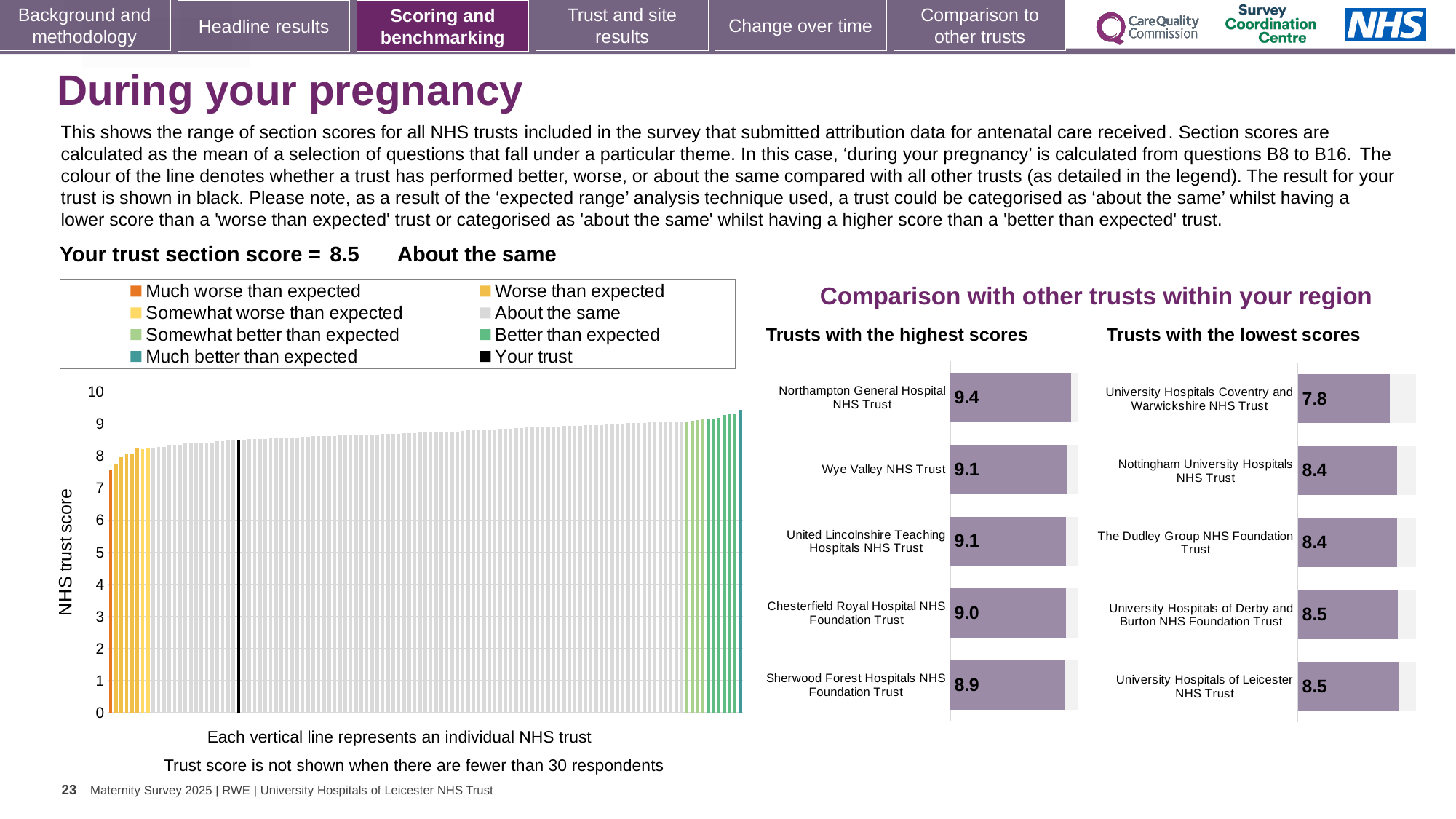
How many entries does the legend of the main chart on the left list? 8 In the 'Trusts with the highest scores' chart, which has the higher score: Wye Valley NHS Trust or Chesterfield Royal Hospital NHS Foundation Trust? Wye Valley NHS Trust In the main chart on the left, do the trust scores rise or fall from left to right? rise In the 'Trusts with the lowest scores' chart, what is the difference between the scores of University Hospitals of Leicester NHS Trust and University Hospitals Coventry and Warwickshire NHS Trust? 0.7 In the 'Trusts with the highest scores' chart, which trust has the lowest score? Sherwood Forest Hospitals NHS Foundation Trust In the 'Trusts with the lowest scores' chart, what is the score for University Hospitals Coventry and Warwickshire NHS Trust? 7.8 In the 'Trusts with the lowest scores' chart, which trust has the lowest score? University Hospitals Coventry and Warwickshire NHS Trust How many trusts are listed in the 'Trusts with the lowest scores' chart? 5 In the 'Trusts with the highest scores' chart, what is the score for Northampton General Hospital NHS Trust? 9.4 What kind of chart is the main chart on the left showing NHS trust scores? bar chart In the main chart on the left, is the value for the black 'Your trust' bar greater or less than 8? greater In the 'Trusts with the highest scores' chart, what is the difference between the scores of Northampton General Hospital NHS Trust and Sherwood Forest Hospitals NHS Foundation Trust? 0.5